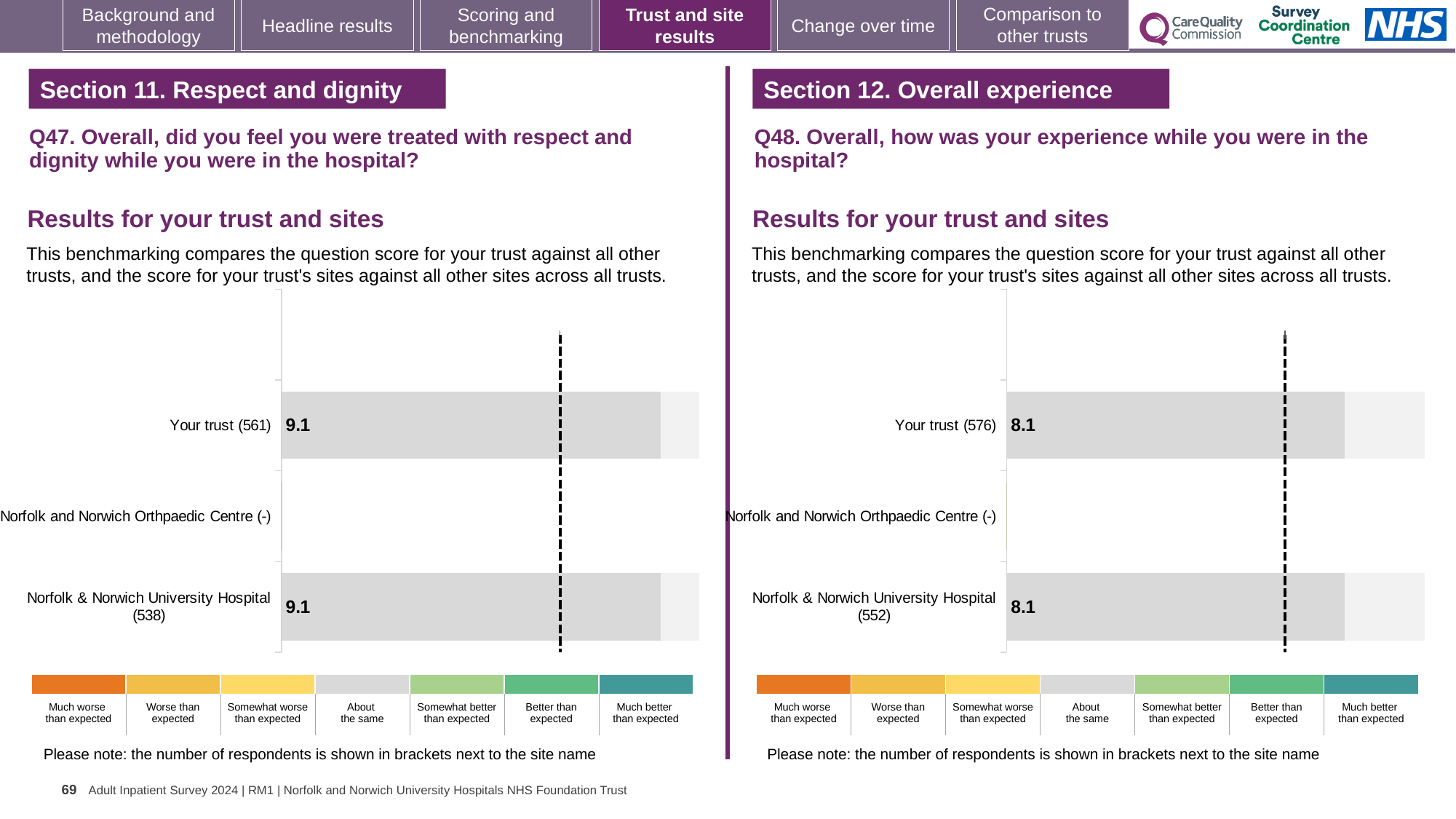
On the Q47 chart (left), what is the score for Norfolk & Norwich University Hospital? 9.1 On the Q47 chart (left), which category has no bar plotted? Norfolk and Norwich Orthpaedic Centre (-) Which is larger: the Your trust score on the Q47 chart (left) or the Your trust score on the Q48 chart (right)? Q47 chart (left) On the Q48 chart (right), what is the score for Norfolk & Norwich University Hospital? 8.1 On the Q47 chart (left), what is the score for Your trust? 9.1 On the Q48 chart (right), what is the score for Your trust? 8.1 On the Q47 chart (left), how many respondents are shown in brackets for Your trust? 561 What is the difference between the Your trust score on the Q47 chart (left) and the Your trust score on the Q48 chart (right)? 1.0 How many site/trust categories are listed on the Q47 chart (left)? 3 How many benchmark bands are shown in the colour key below the Q48 chart (right)? 7 What kind of chart is the Q48 chart (right)? bar chart On the Q48 chart (right), how many respondents are shown in brackets for Norfolk & Norwich University Hospital? 552